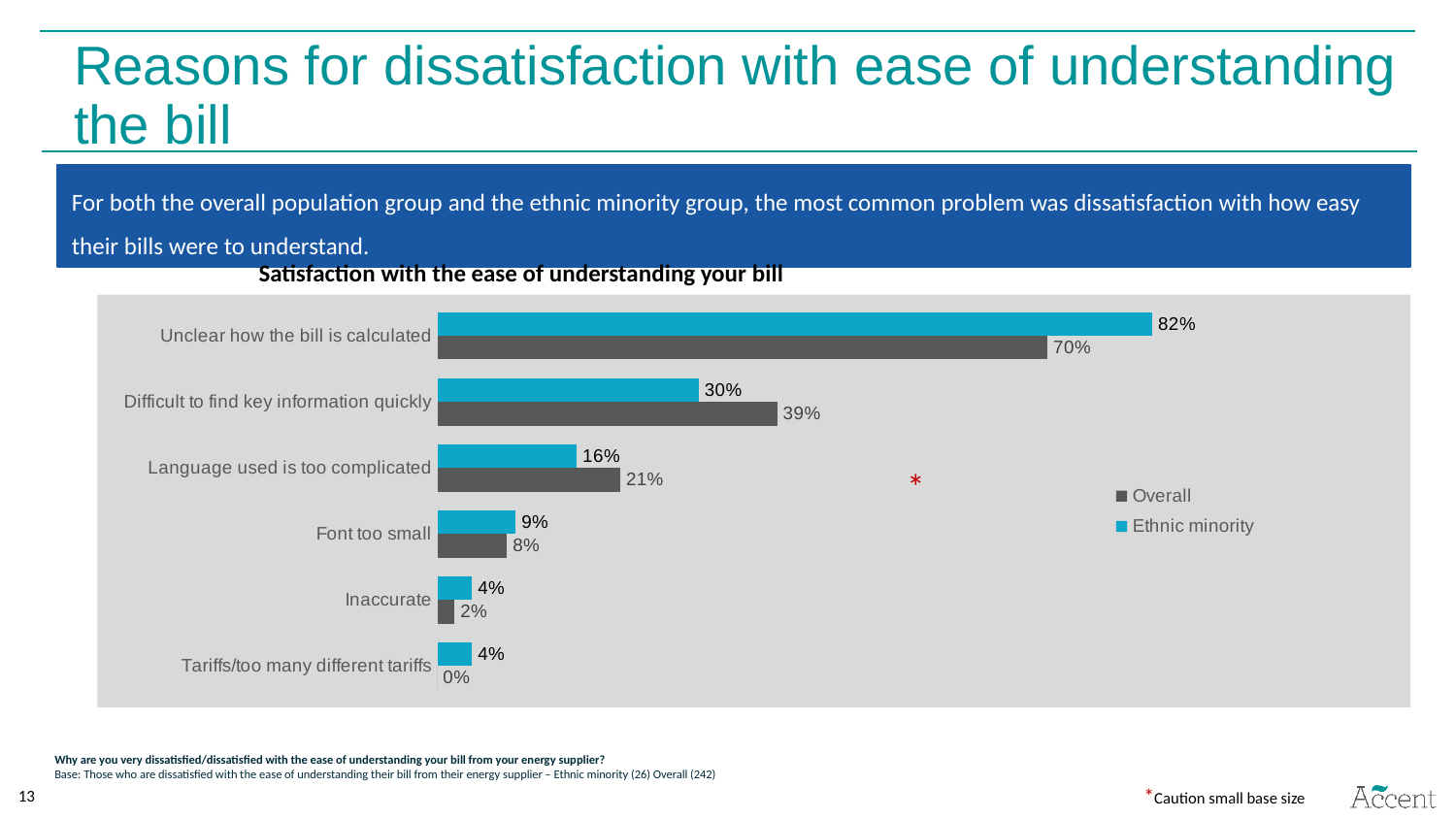
What is the Ethnic minority value for 'Unclear how the bill is calculated'? 82% What is the difference between the Ethnic minority and Overall values for 'Unclear how the bill is calculated'? 12% What is the Overall value for 'Difficult to find key information quickly'? 39% What is the Overall value for 'Tariffs/too many different tariffs'? 0% What is the difference between the Overall and Ethnic minority values for 'Language used is too complicated'? 5% What type of chart is shown on the slide? Bar chart How many series does the legend list? 2 Which is larger for 'Difficult to find key information quickly': the Overall value or the Ethnic minority value? Overall How many categories are shown in the chart? 6 Which category has the highest Overall value? Unclear how the bill is calculated What is the Ethnic minority value for 'Font too small'? 9% Which category has the lowest Overall value? Tariffs/too many different tariffs